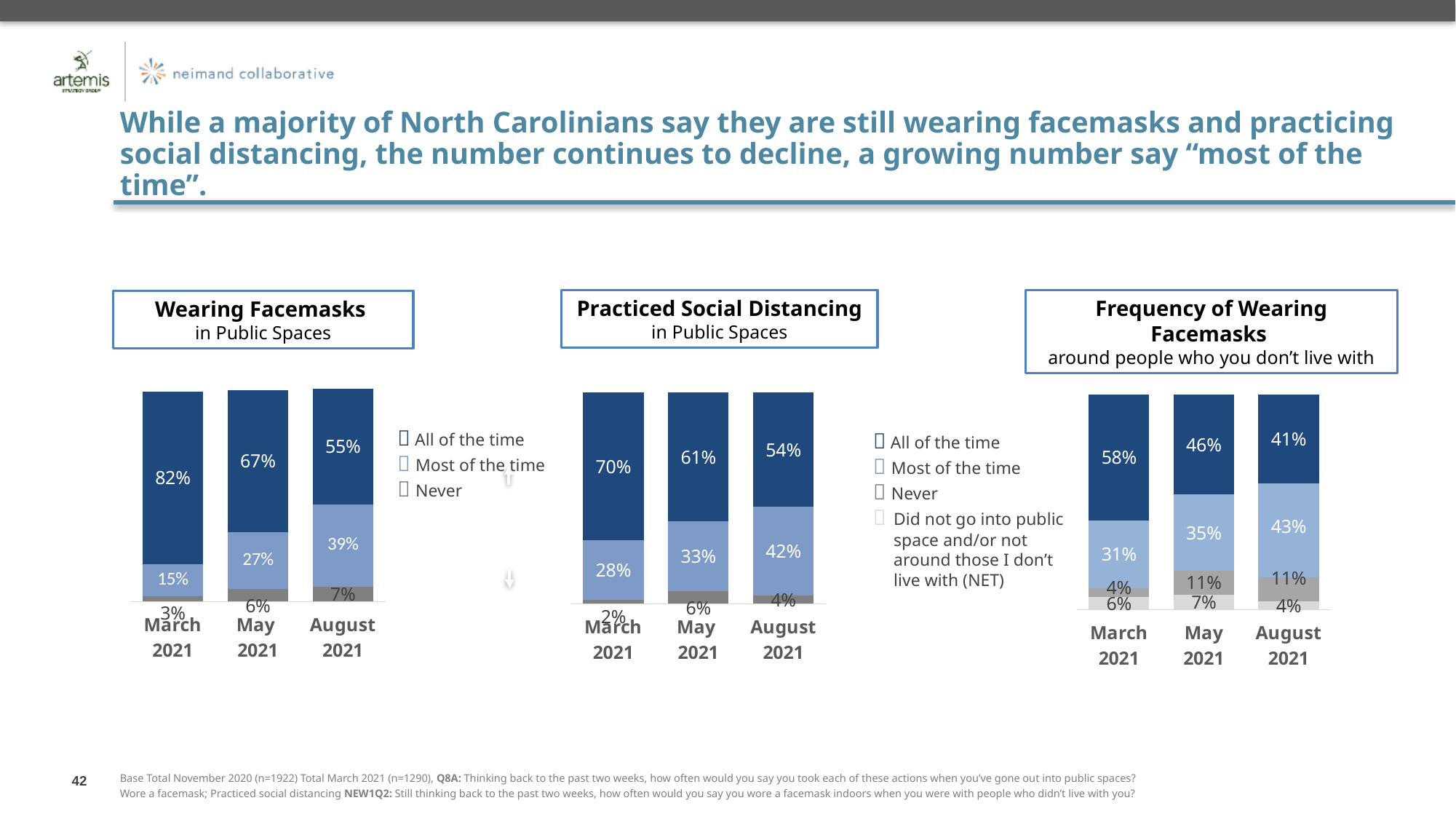
In the 'Wearing Facemasks in Public Spaces' chart, does the 'All of the time' share rise or fall from March 2021 to August 2021? fall In the 'Practiced Social Distancing in Public Spaces' chart, what percentage said 'Most of the time' in May 2021? 33% In the 'Wearing Facemasks in Public Spaces' chart, by how many percentage points did 'All of the time' fall from March 2021 to August 2021? 27 In the 'Frequency of Wearing Facemasks around people who you don't live with' chart, what is the difference between 'Most of the time' in August 2021 and March 2021? 12 In the 'Wearing Facemasks in Public Spaces' chart, what percentage said 'All of the time' in March 2021? 82% How many series does the legend of the 'Frequency of Wearing Facemasks' chart list? 4 In the 'Wearing Facemasks in Public Spaces' chart, what percentage said 'Most of the time' in August 2021? 39% In the 'Frequency of Wearing Facemasks around people who you don't live with' chart, what percentage said 'All of the time' in August 2021? 41% In the 'Practiced Social Distancing in Public Spaces' chart, which is larger in August 2021: 'All of the time' or 'Most of the time'? All of the time What type of chart is the 'Practiced Social Distancing in Public Spaces' chart? Stacked bar chart In the 'Frequency of Wearing Facemasks around people who you don't live with' chart, which is larger in August 2021: 'All of the time' or 'Most of the time'? Most of the time In the 'Practiced Social Distancing in Public Spaces' chart, which month has the lowest 'Never' value? March 2021